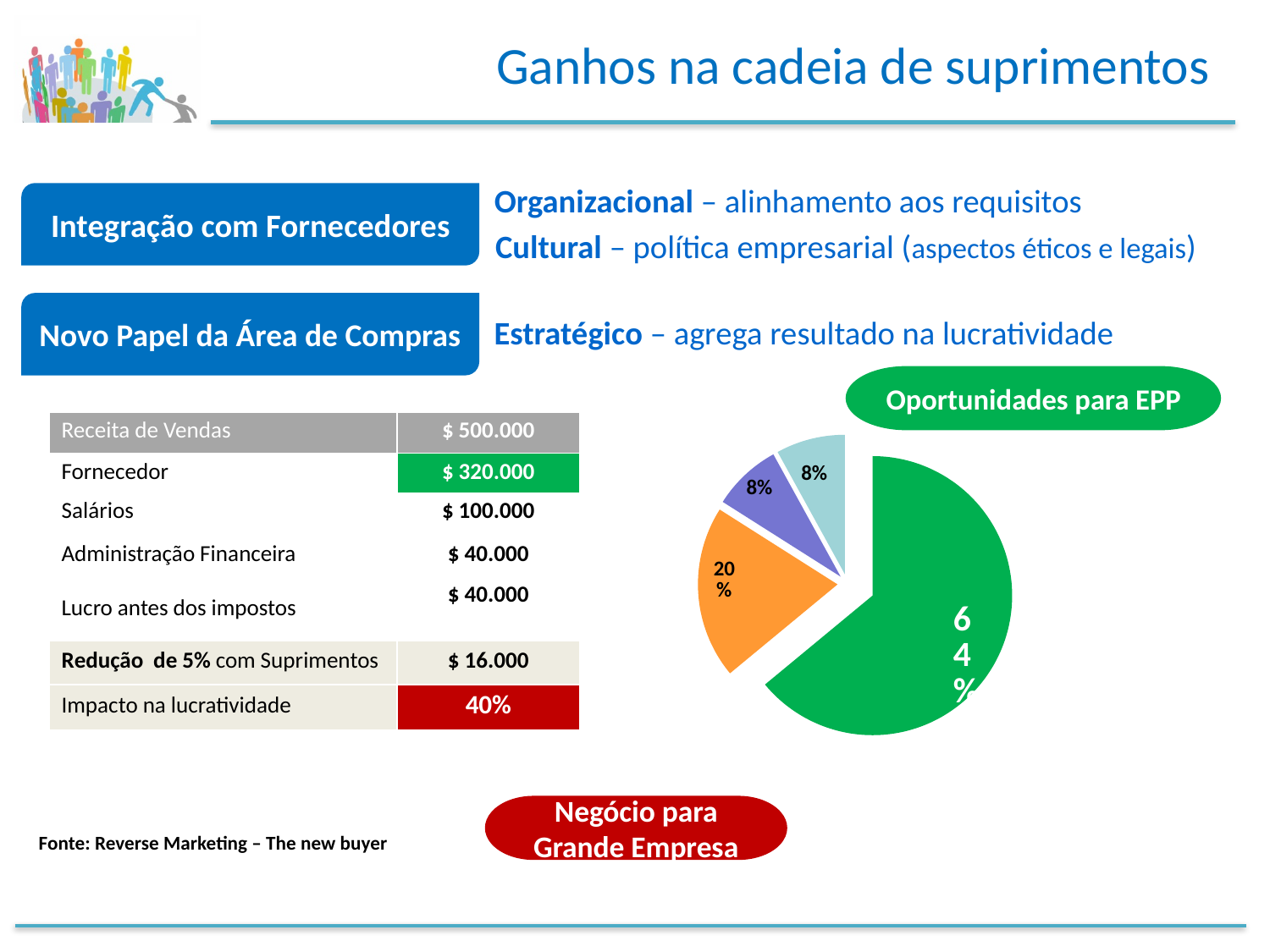
What is the combined share of the two 8% slices in the pie chart? 16% What value is shown on the orange slice of the pie chart? 20% How many slices does the pie chart have? 4 Which slice is larger in the pie chart, the green one or the orange one? The green one What is the value of the smallest slice in the pie chart? 8% What is the value of the largest slice in the pie chart? 64% How many slices in the pie chart are labelled 8%? 2 What is the difference between the green slice and the orange slice in the pie chart? 44 percentage points What value is shown on the green slice of the pie chart? 64% What kind of chart is shown on the slide? Pie chart What colour is the largest slice of the pie chart? Green Does the largest slice of the pie chart account for more or less than half of the pie? More